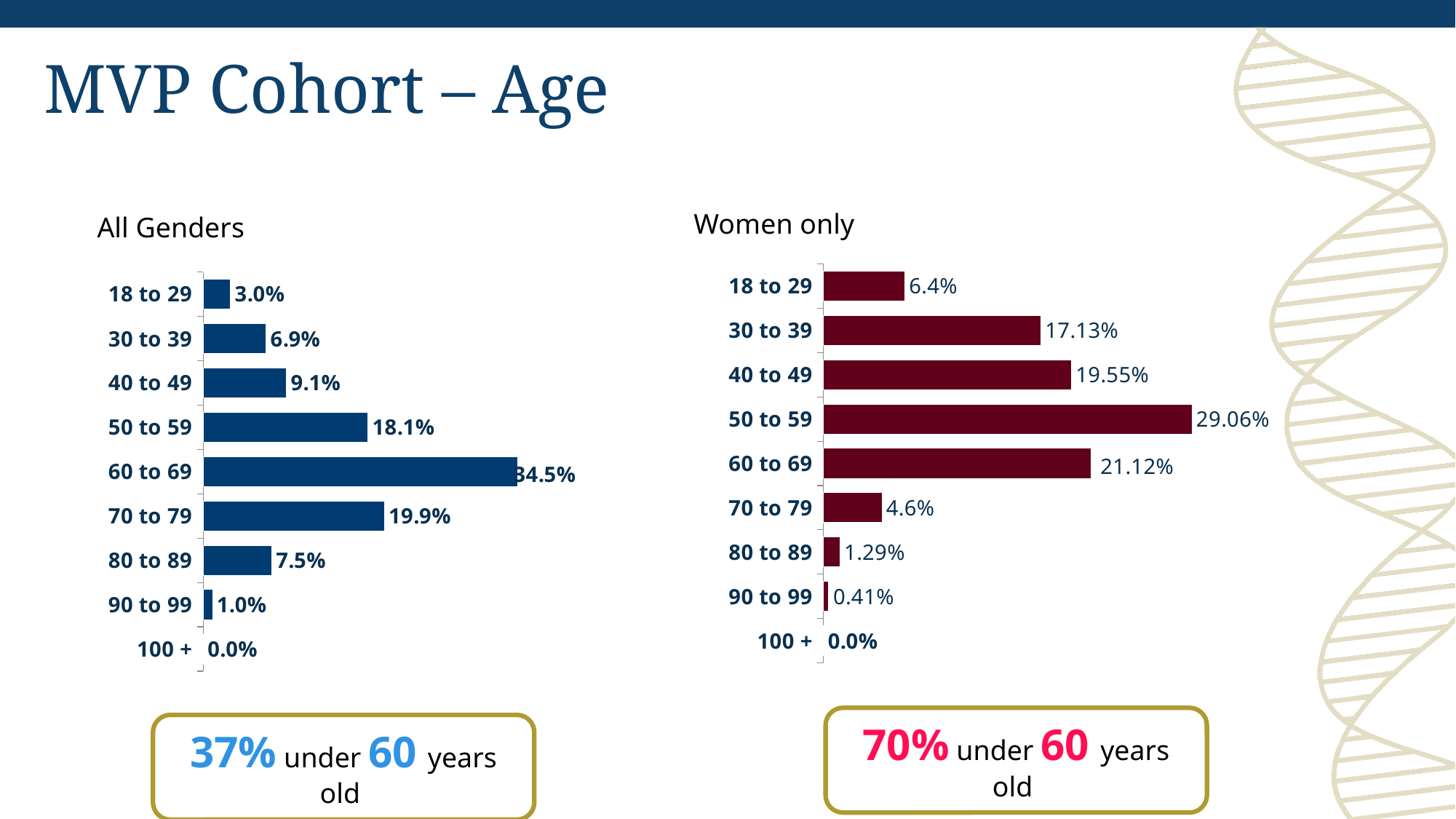
In the All Genders chart, what is the value for 60 to 69? 34.5% In the Women only chart, which age group has the highest value? 50 to 59 How many age groups are shown in the All Genders chart? 9 In the Women only chart, what is the value for 80 to 89? 1.29% In the All Genders chart, which age group has the highest value? 60 to 69 In the Women only chart, what is the value for 50 to 59? 29.06% What kind of chart is the Women only chart? Bar chart In the Women only chart, what is the difference between the values for 40 to 49 and 30 to 39? 2.42% In the All Genders chart, what is the difference between the values for 70 to 79 and 50 to 59? 1.8% In the All Genders chart, which age group has the lowest value? 100 + What colour are the bars in the Women only chart? Dark red In the Women only chart, which is larger, the value for 60 to 69 or the value for 40 to 49? 60 to 69